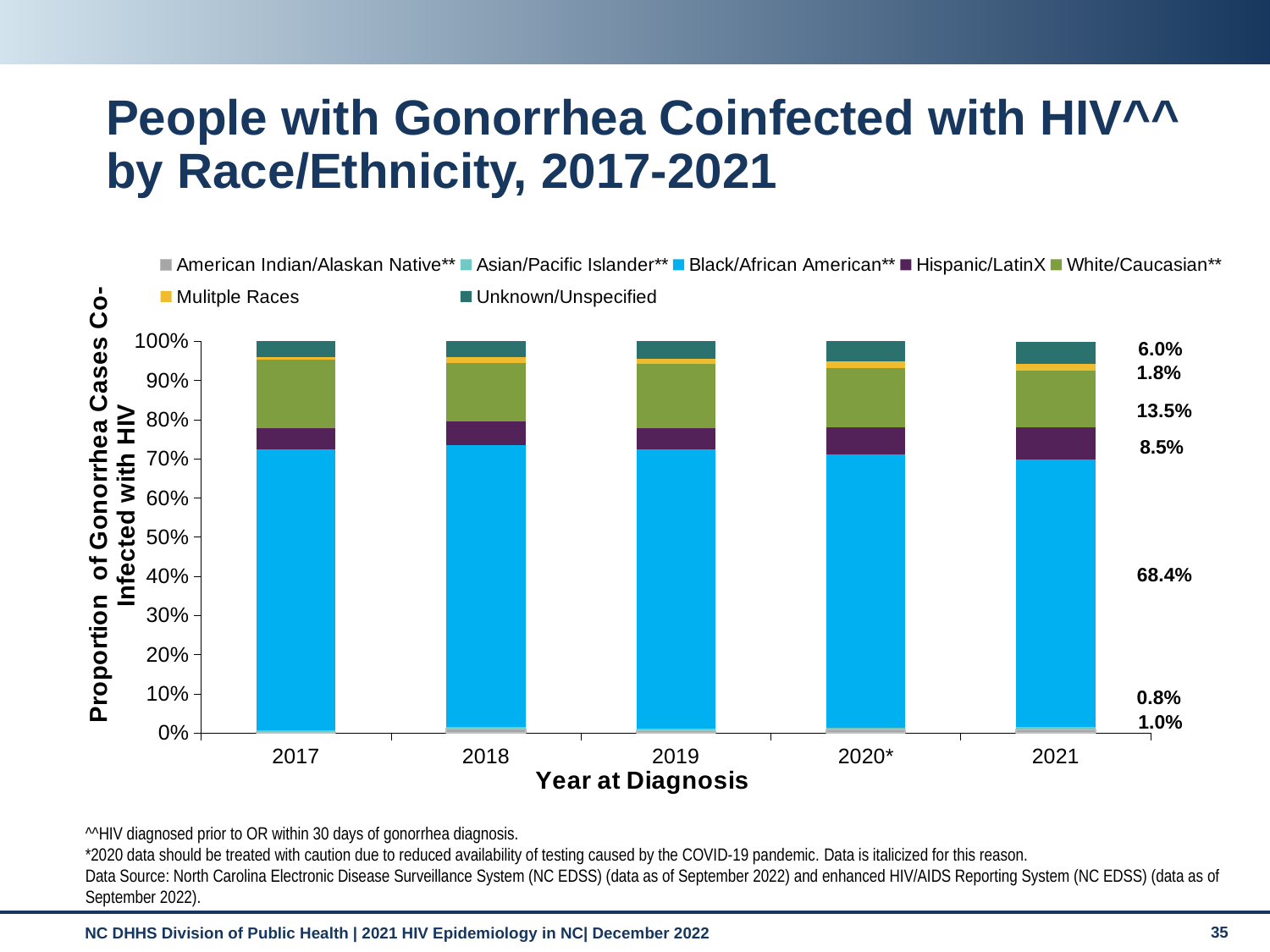
Is the Black/African American share of gonorrhea cases co-infected with HIV in 2017 greater or less than 60%? greater What proportion of gonorrhea cases co-infected with HIV in 2021 were of Multiple Races? 1.8% What is the title of the x axis? Year at Diagnosis In 2021, how many percentage points larger is the White/Caucasian share than the Hispanic/LatinX share? 5.0 percentage points What proportion of gonorrhea cases co-infected with HIV in 2021 were Black/African American? 68.4% Which race/ethnicity group had the largest share of gonorrhea cases co-infected with HIV in 2021? Black/African American What kind of chart is shown on the slide? Stacked bar chart How many race/ethnicity series does the legend list? 7 What proportion of gonorrhea cases co-infected with HIV in 2021 were White/Caucasian? 13.5% What proportion of gonorrhea cases co-infected with HIV in 2021 were Unknown/Unspecified race? 6.0% How many years are shown on the x axis? 5 What proportion of gonorrhea cases co-infected with HIV in 2021 were Hispanic/LatinX? 8.5%